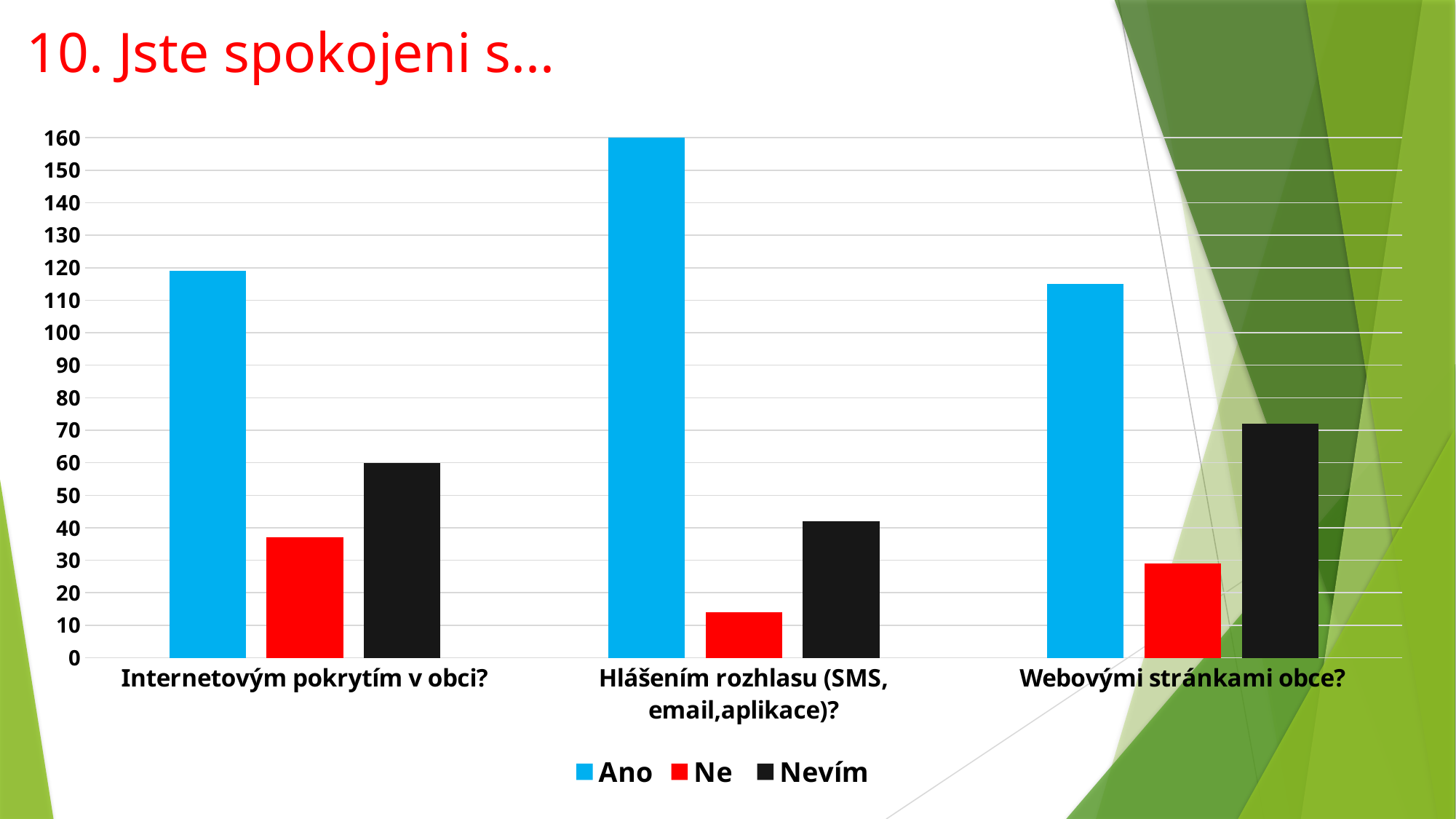
Which category has the highest Nevím value? Webovými stránkami obce? Which category has the highest Ano value? Hlášením rozhlasu (SMS, email,aplikace)? Which colour represents the Ne series in the legend? red Which category has the lowest Ne value? Hlášením rozhlasu (SMS, email,aplikace)? Which is larger for "Webovými stránkami obce?": the Ne value or the Nevím value? Nevím How many series does the legend list? 3 Is the Ne value for "Internetovým pokrytím v obci?" greater or less than 40? less Is the Ano value for "Webovými stránkami obce?" greater or less than 100? greater How many categories are shown on the x axis? 3 What kind of chart is shown on the slide? bar chart What is the value of Nevím for "Internetovým pokrytím v obci?"? 60 What is the value of Ano for "Hlášením rozhlasu (SMS, email,aplikace)?"? 160